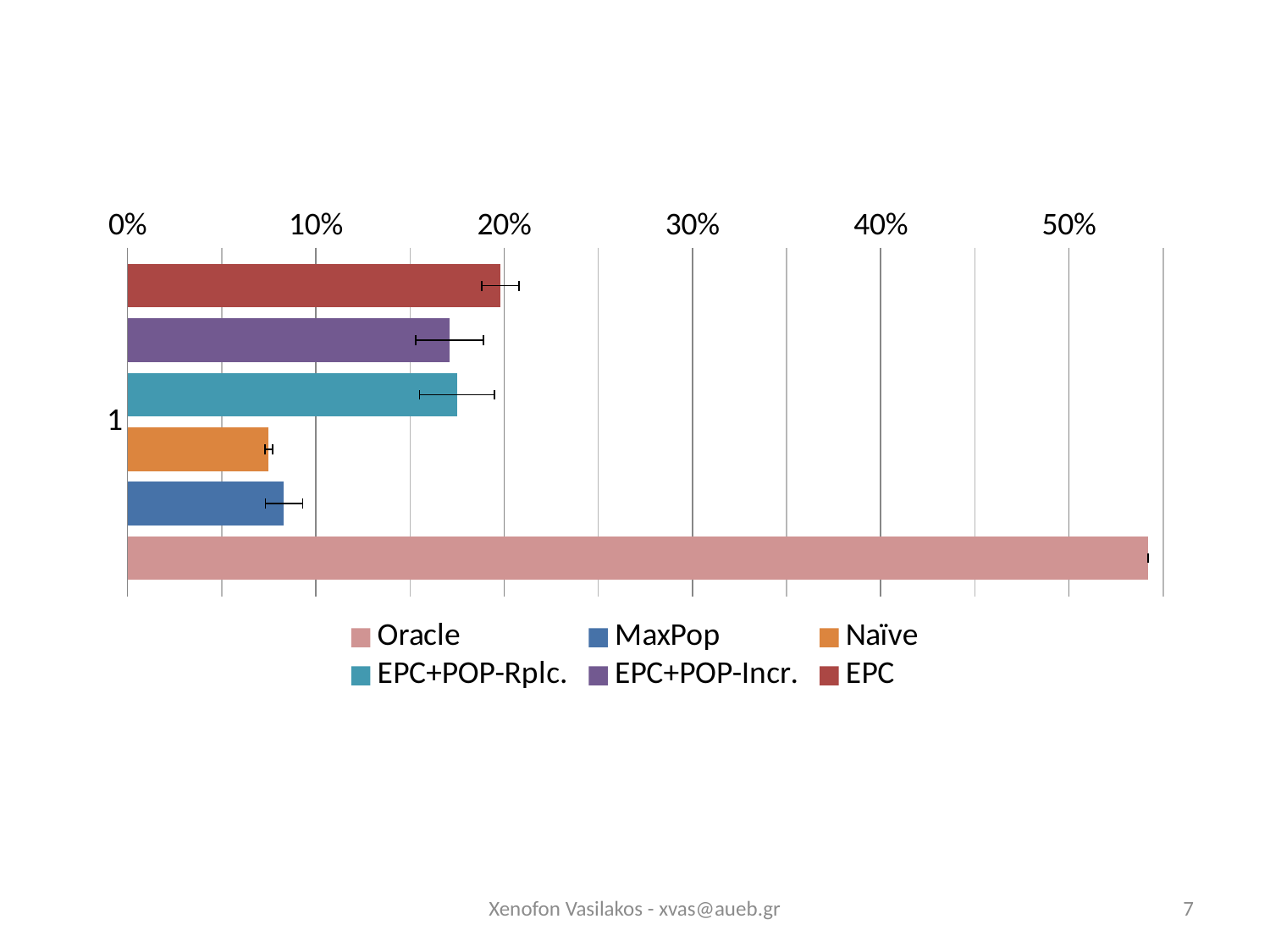
How many categories are shown on the vertical axis? 1 Which series is shown in the legend with the first (leftmost) entry in the top row? Oracle Which series has the highest value? Oracle How many series does the legend list? 6 Is the value for EPC+POP-Incr. greater or less than 10%? greater Is the value for Naïve greater or less than 10%? less Which is larger, the value for EPC or the value for MaxPop? EPC What is the label of the single category on the vertical axis? 1 Which is larger, the value for Oracle or the value for EPC? Oracle Is the value for Oracle greater or less than 50%? greater What kind of chart is shown on the slide? bar chart